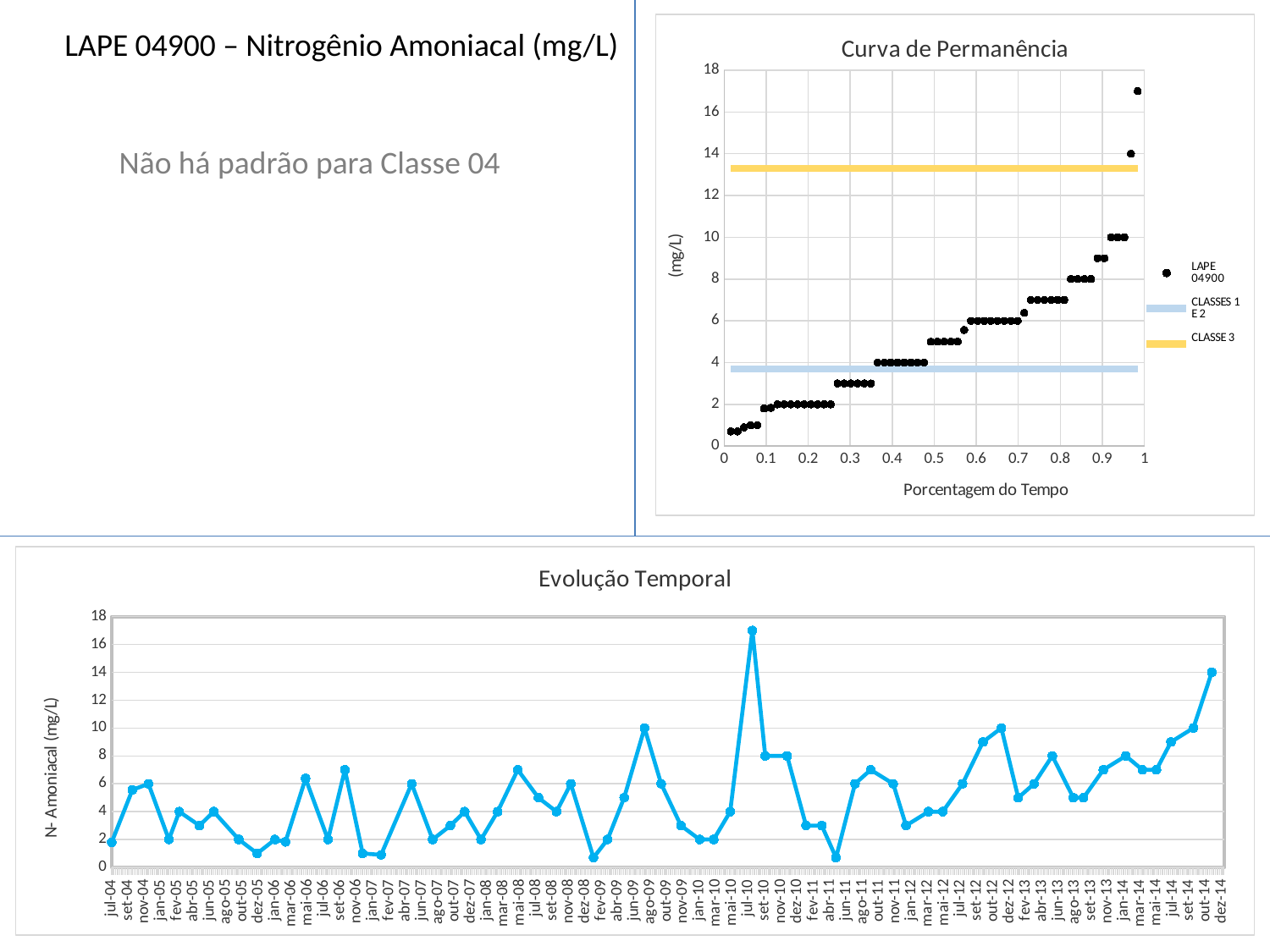
In the 'Curva de Permanência' chart, do the LAPE 04900 values rise or fall along the x axis? rise What kind of chart is the 'Evolução Temporal' chart? line chart What kind of chart is the 'Curva de Permanência' chart? scatter chart In the 'Curva de Permanência' chart, is the highest LAPE 04900 point greater or less than 16? greater In the 'Evolução Temporal' chart, which date has the highest value? jul-10 In the 'Curva de Permanência' chart, is the CLASSE 3 line greater or less than 12? greater In the 'Curva de Permanência' chart, is the CLASSES 1 E 2 line greater or less than 2? greater What are the legend entries of the 'Curva de Permanência' chart? LAPE 04900, CLASSES 1 E 2, CLASSE 3 In the 'Evolução Temporal' chart, which is larger, the value for jul-10 or the value for dez-14? jul-10 How many series does the legend of the 'Curva de Permanência' chart list? 3 What is the x-axis title of the 'Curva de Permanência' chart? Porcentagem do Tempo